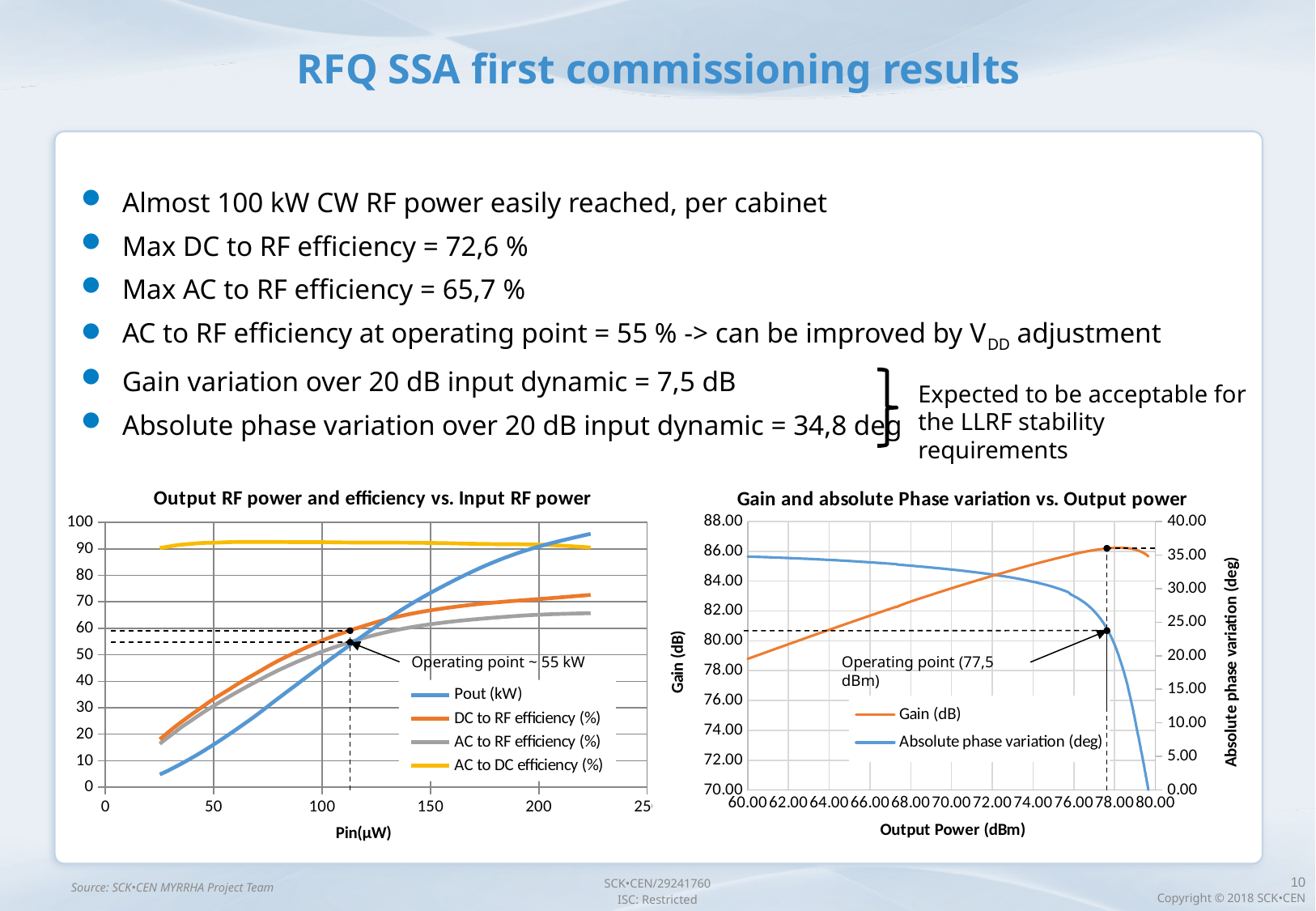
On the right chart, 'Gain and absolute Phase variation vs. Output power', how many series does the legend list? 2 On the left chart, 'Output RF power and efficiency vs. Input RF power', is the value of AC to DC efficiency (%) at Pin = 100 greater or less than 80? greater On the left chart, 'Output RF power and efficiency vs. Input RF power', is the value of DC to RF efficiency (%) at Pin = 50 greater or less than 40? less On the left chart, 'Output RF power and efficiency vs. Input RF power', what kind of chart is it? Line chart On the left chart, 'Output RF power and efficiency vs. Input RF power', how many series does the legend list? 4 On the right chart, 'Gain and absolute Phase variation vs. Output power', does Gain (dB) rise or fall as Output Power increases? Rise On the right chart, 'Gain and absolute Phase variation vs. Output power', is the Gain (dB) at 60.00 dBm output power greater or less than 80.00? less On the right chart, 'Gain and absolute Phase variation vs. Output power', does Absolute phase variation (deg) rise or fall as Output Power increases? Fall On the left chart, 'Output RF power and efficiency vs. Input RF power', does Pout (kW) rise or fall as Pin increases? Rise On the left chart, 'Output RF power and efficiency vs. Input RF power', what is the x-axis title? Pin(µW)